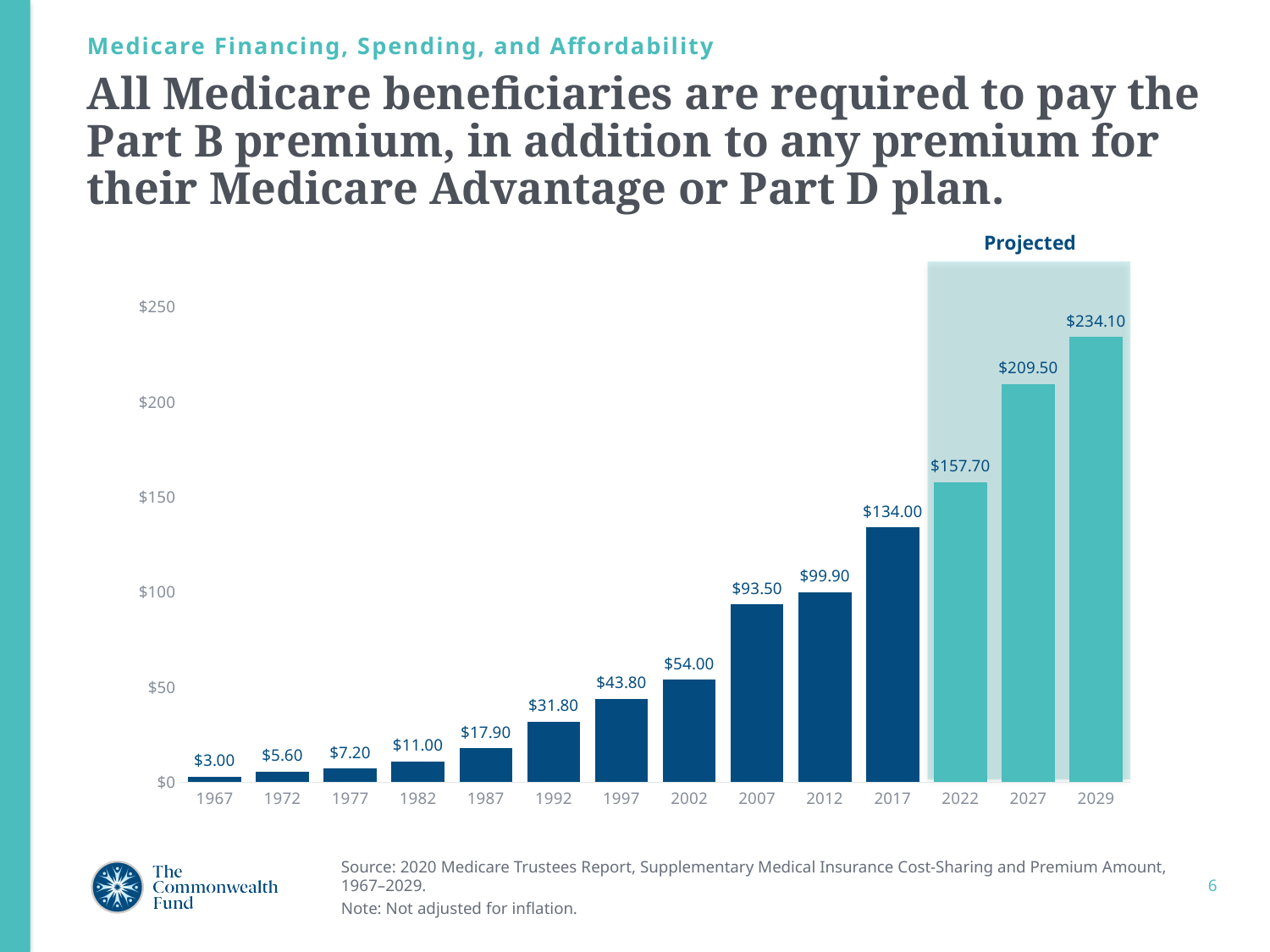
What is the difference between the values for 2012 and 2007? $6.40 What kind of chart is shown on the slide? Bar chart Which year has the highest value on the chart? 2029 Which is larger, the value for 2002 or the value for 1997? 2002 What is the projected value shown for 2029? $234.10 What is the Part B premium value shown for 2017? $134.00 What is the value shown for 1987? $17.90 How many years are shown on the x axis? 14 What is the difference between the values for 2027 and 2022? $51.80 Which year has the lowest value on the chart? 1967 Is the value for 2022 greater or less than $150? greater Do the values rise or fall from 1967 to 2029? Rise